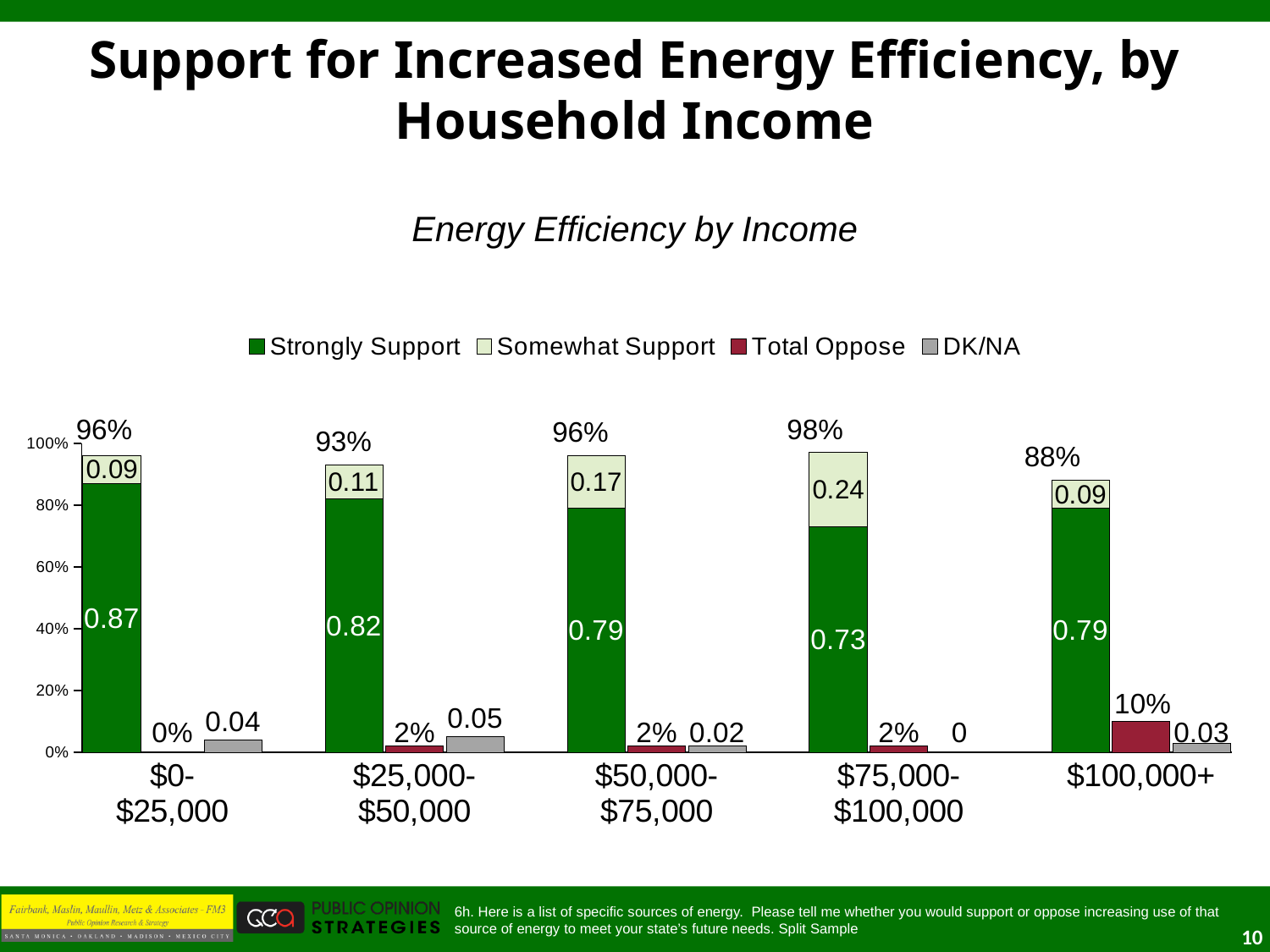
What is the Somewhat Support value for the $75,000-$100,000 income group? 0.24 What is the difference between the Strongly Support values for the $0-$25,000 and $75,000-$100,000 income groups? 0.14 Which income group has the highest Strongly Support value? $0-$25,000 What is the Strongly Support value for the $0-$25,000 income group? 0.87 What is the Total Oppose value for the $100,000+ income group? 10% Which income group has the lowest total support percentage shown above its stacked bar? $100,000+ What kind of chart is shown on the slide? Bar chart How many series does the legend list? 4 How many income groups are shown on the x axis? 5 Which income group has the lowest Strongly Support value? $75,000-$100,000 What is the DK/NA value for the $25,000-$50,000 income group? 0.05 Is the Somewhat Support value larger for the $50,000-$75,000 group or the $100,000+ group? $50,000-$75,000